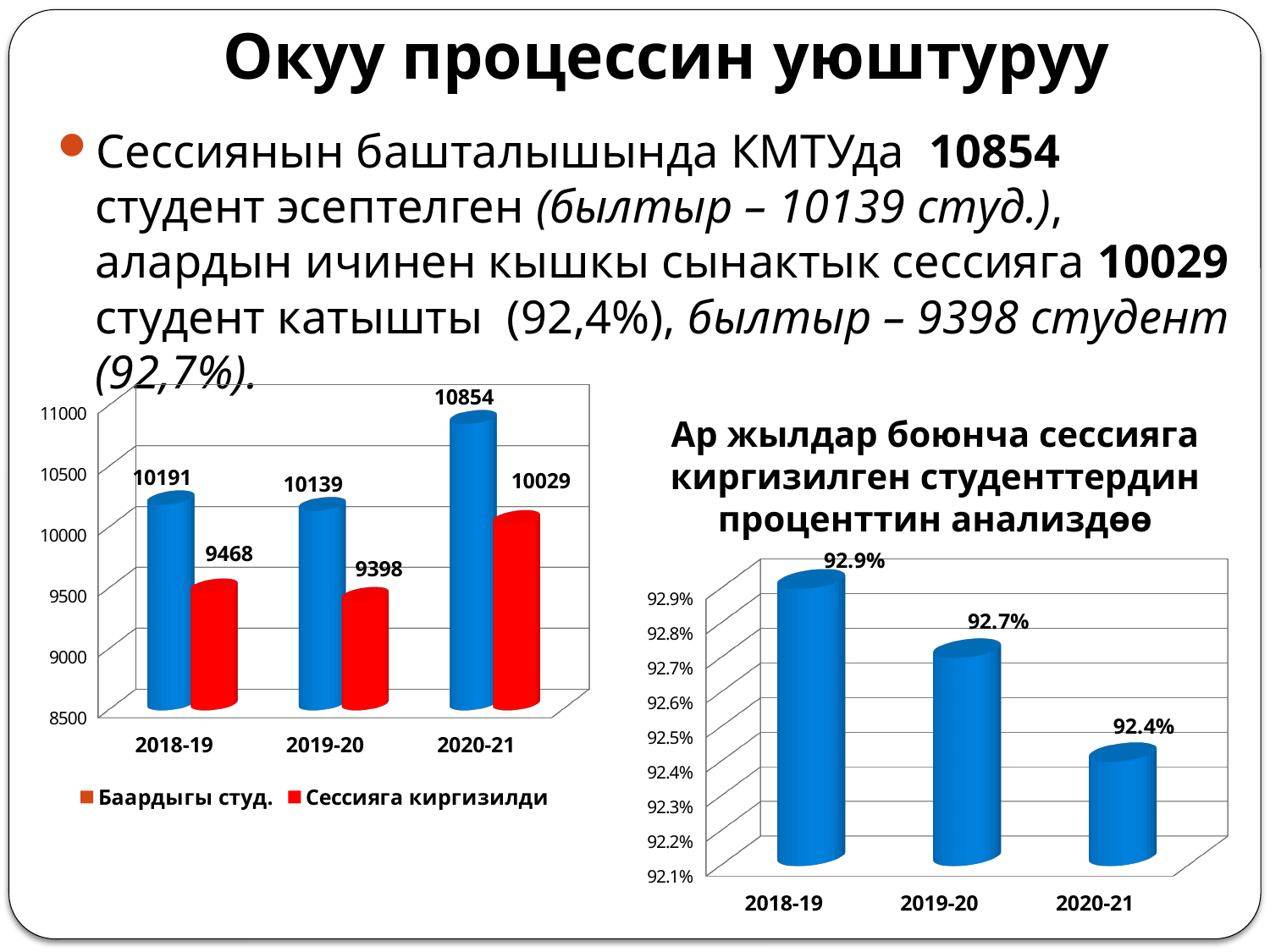
What kind of chart is the chart on the right of the slide? bar chart In the left chart, which is larger: Баардыгы студ. in 2018-19 or Баардыгы студ. in 2019-20? Баардыгы студ. in 2018-19 In the left chart, what is the value for Сессияга киргизилди in 2019-20? 9398 In the left chart, what is the value for Сессияга киргизилди in 2018-19? 9468 In the left chart, what is the value for Баардыгы студ. in 2020-21? 10854 In the chart titled 'Ар жылдар боюнча сессияга киргизилген студенттердин проценттин анализдөө', do the values rise or fall from 2018-19 to 2020-21? fall In the left chart, which year has the lowest value for Сессияга киргизилди? 2019-20 In the chart titled 'Ар жылдар боюнча сессияга киргизилген студенттердин проценттин анализдөө', what is the difference between the 2018-19 and 2020-21 values? 0.5% How many series does the legend of the left chart list? 2 In the chart titled 'Ар жылдар боюнча сессияга киргизилген студенттердин проценттин анализдөө', what is the value for 2019-20? 92.7% In the left chart, what is the difference between Баардыгы студ. and Сессияга киргизилди in 2020-21? 825 In the left chart, which year has the highest value for Баардыгы студ.? 2020-21